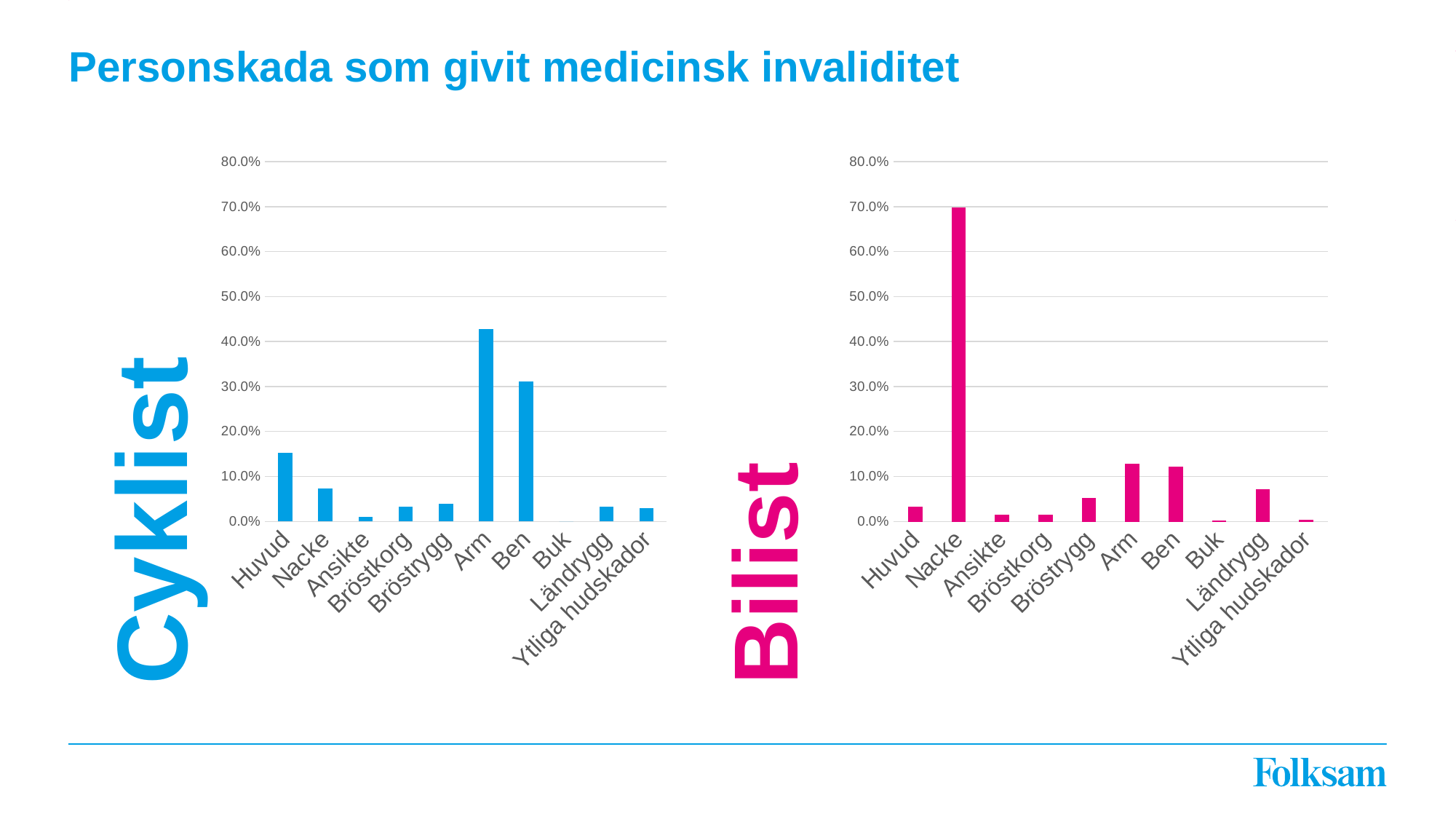
In the Bilist chart, is the value for Arm greater or less than 20.0%? less In the Cyklist chart, is the value for Ben greater or less than 40.0%? less In the Bilist chart, which is larger, the value for Ländrygg or the value for Huvud? Ländrygg In the Bilist chart, is the value for Nacke greater or less than 60.0%? greater How many categories are shown on the x axis of the Cyklist chart? 10 In the Cyklist chart, which category has the highest value? Arm What kind of chart is the Bilist chart? Bar chart What colour are the bars in the Bilist chart? Pink In the Cyklist chart, which is larger, the value for Huvud or the value for Nacke? Huvud In the Bilist chart, which category has the highest value? Nacke What is the title of the slide above the two charts? Personskada som givit medicinsk invaliditet